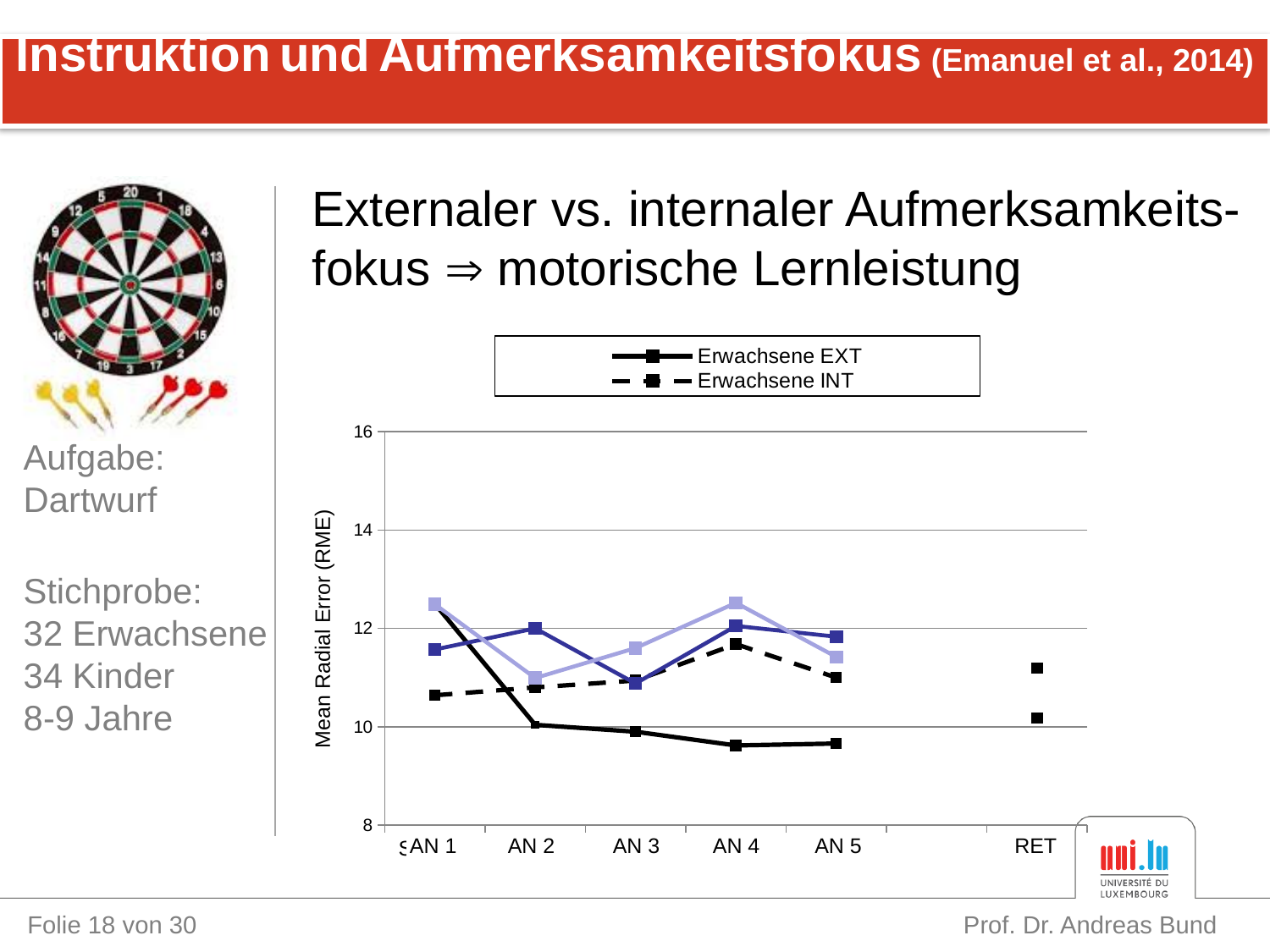
How many categories are labelled on the x axis of the chart? 6 Is the value for Erwachsene EXT at AN 1 greater or less than 12? greater Is the value for Erwachsene INT at AN 4 greater or less than 12? less What is the label of the y axis of the chart? Mean Radial Error (RME) At which x-axis category does the Erwachsene EXT series reach its highest value? AN 1 What kind of chart is shown on the slide? line chart At AN 5, which series has the larger value, Erwachsene EXT or Erwachsene INT? Erwachsene INT Is the value for Erwachsene EXT at AN 4 greater or less than 10? less How many series does the chart's legend list? 2 Which series is drawn with a dashed line in the chart's legend? Erwachsene INT Does the Erwachsene EXT series rise or fall from AN 1 to AN 5? fall